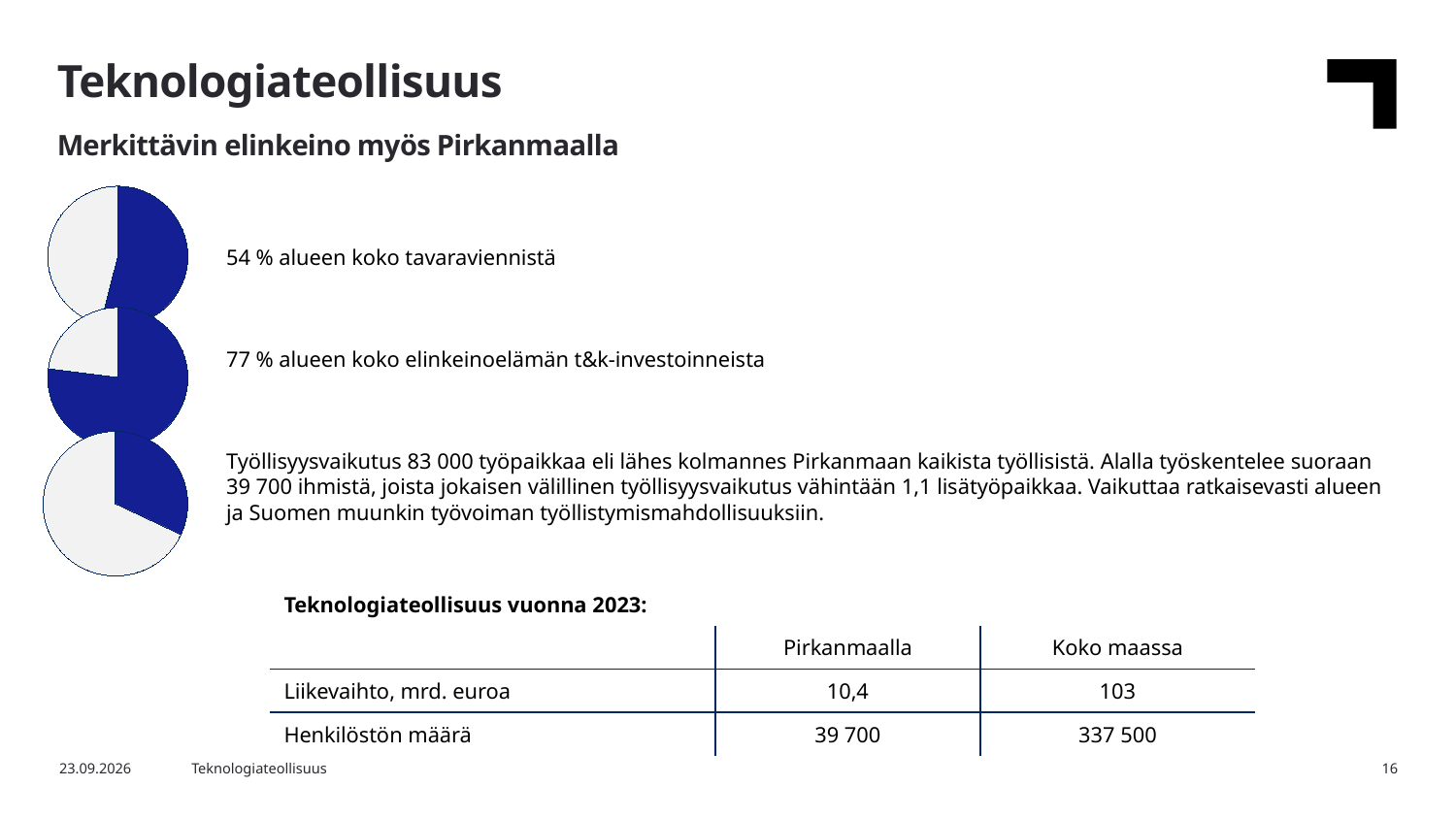
Which of the three pie charts has the largest blue slice? The middle pie chart (77 % of R&D investments) In the middle pie chart, what share of the region's business R&D investments does the blue slice represent? 77 % In the top pie chart, what share of the region's total goods exports does the blue slice represent? 54 % How many pie charts are on the slide? 3 Is the blue slice in the bottom pie chart more or less than half of the pie? Less What kind of charts are shown on the left side of the slide? Pie charts Which of the three pie charts has the smallest blue slice? The bottom pie chart (employment effect) What text accompanies the top pie chart? 54 % alueen koko tavaraviennistä What is the difference between the share shown for the middle pie chart (77 %) and the top pie chart (54 %)? 23 percentage points What colour is used for the highlighted slice in each pie chart? Blue Is the blue slice larger in the top pie chart or in the middle pie chart? The middle pie chart